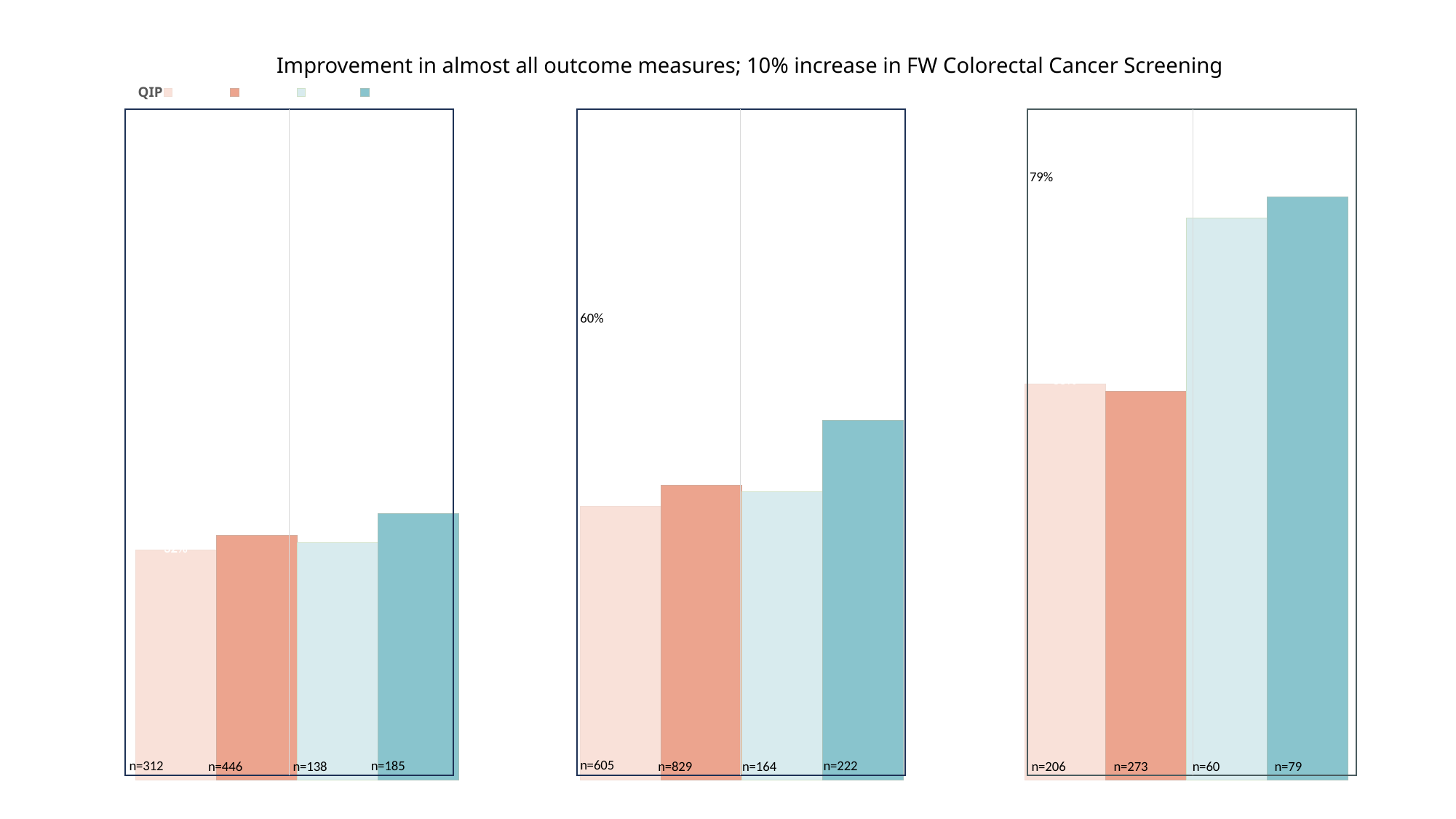
In the right chart, which is taller, the third bar or the fourth bar? the fourth bar What kind of chart is the left chart? bar chart In the middle chart, which bar is the tallest? the fourth (rightmost) bar In the middle chart, what is the n label printed under the second bar? n=829 In the left chart, what is the n label printed under the fourth (rightmost) bar? n=185 In the right chart, what is the n label printed under the third bar? n=60 How many bars does the middle chart show? 4 In the right chart, what is the n label printed under the fourth (rightmost) bar? n=79 In the middle chart, which is taller, the first bar or the fourth bar? the fourth bar In the left chart, what is the n label printed under the first (leftmost) bar? n=312 What is the title of the slide's charts? Improvement in almost all outcome measures; 10% increase in FW Colorectal Cancer Screening